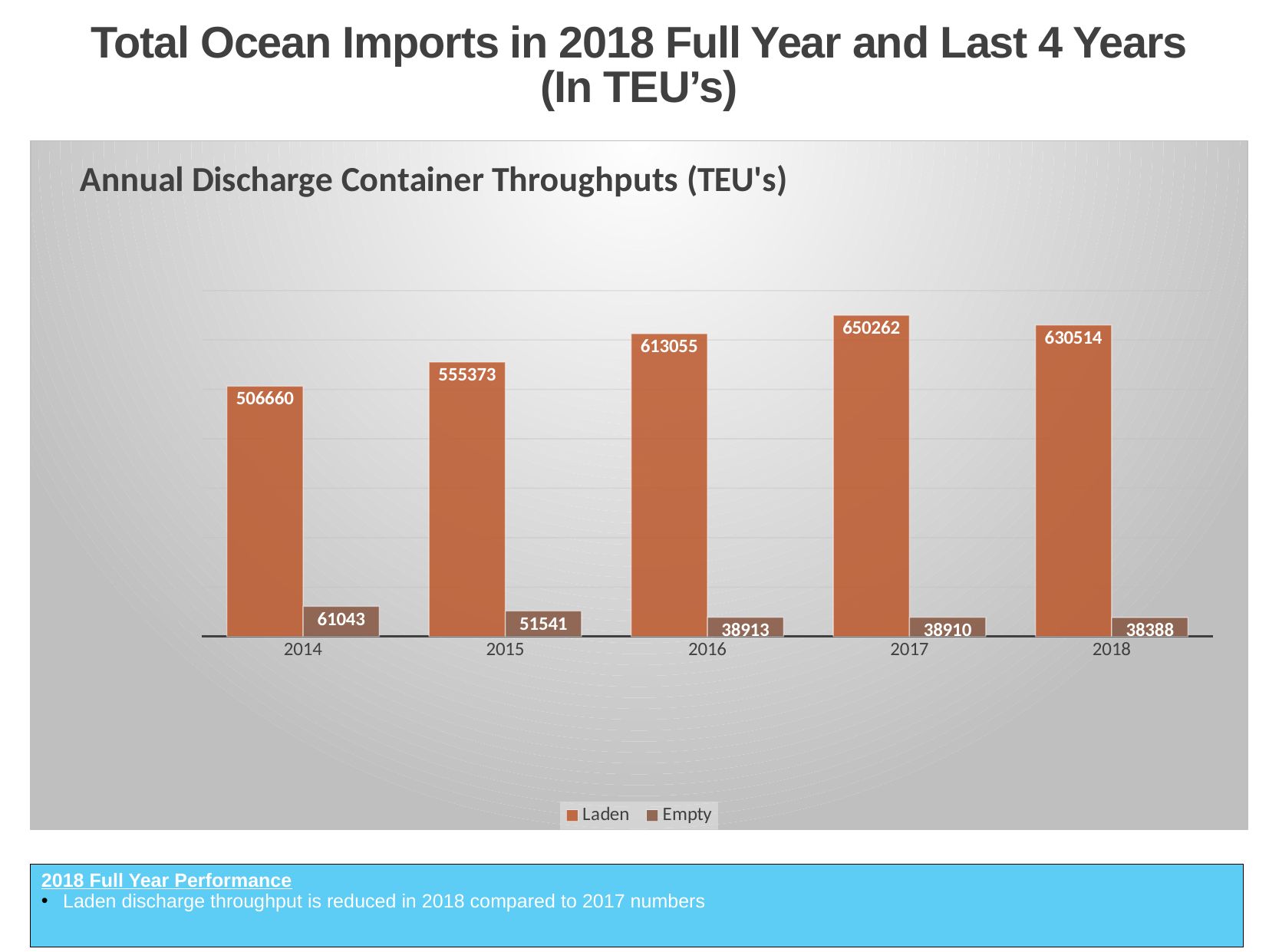
Which year has the lowest Empty value? 2018 Which year has the highest Laden value? 2017 What is the Laden value for 2018? 630514 What is the title of the chart? Annual Discharge Container Throughputs (TEU's) What is the difference between the Laden values for 2017 and 2018? 19748 How many years are shown on the x axis? 5 What kind of chart is shown? bar chart Does the Empty series rise or fall from 2014 to 2018? fall What is the Laden value for 2016? 613055 Which is larger, the Empty value for 2014 or the Empty value for 2015? 2014 What is the Empty value for 2014? 61043 How many series does the legend list? 2